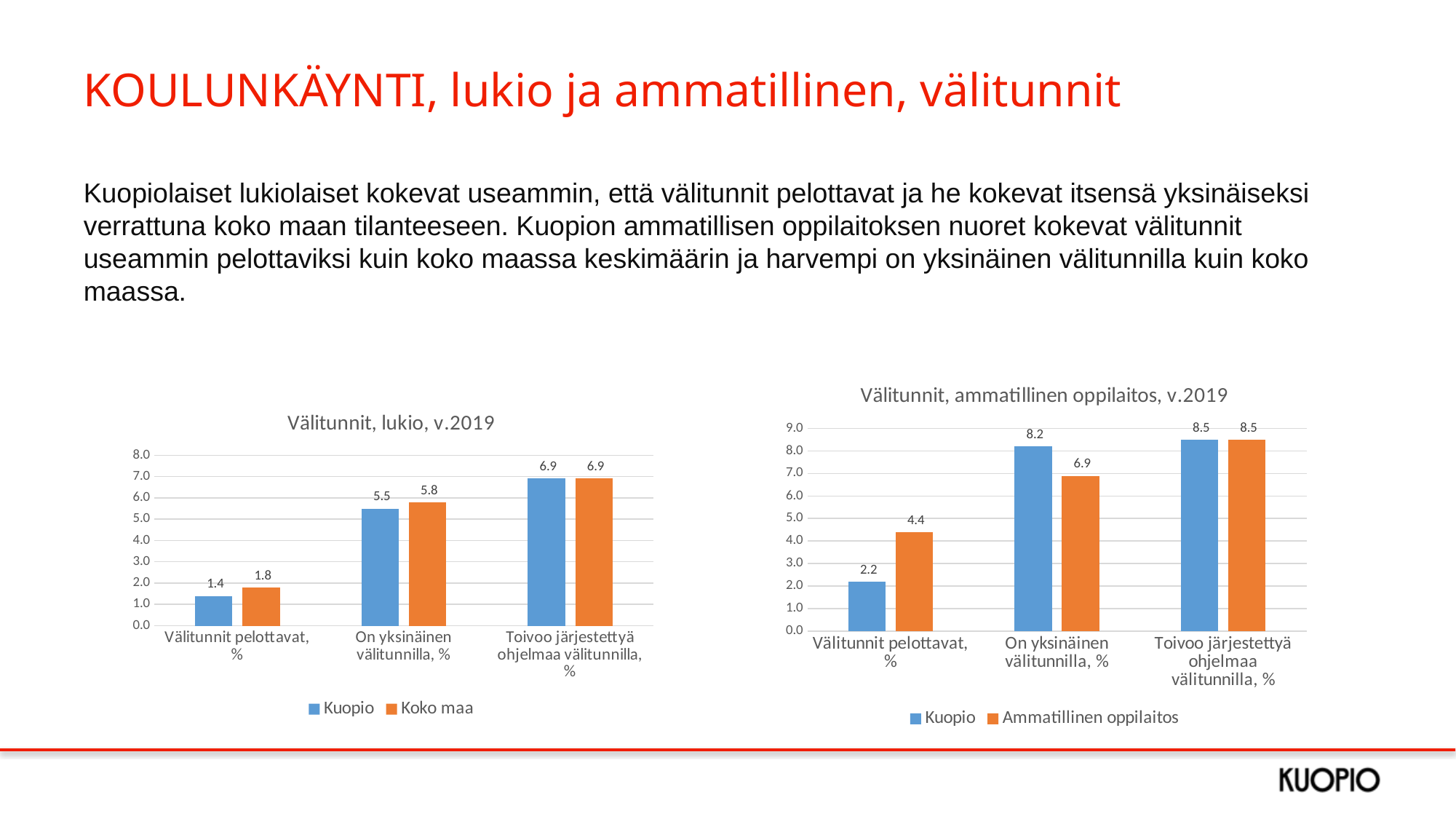
How many series does the legend of the chart 'Välitunnit, ammatillinen oppilaitos, v.2019' list? 2 In the chart 'Välitunnit, lukio, v.2019', which category has the lowest Koko maa value? Välitunnit pelottavat, % How many categories are shown on the x axis of the chart 'Välitunnit, lukio, v.2019'? 3 In the chart 'Välitunnit, ammatillinen oppilaitos, v.2019', which is larger for 'Välitunnit pelottavat, %': Kuopio or Ammatillinen oppilaitos? Ammatillinen oppilaitos In the chart 'Välitunnit, lukio, v.2019', what is the difference between the Koko maa and Kuopio values for 'Välitunnit pelottavat, %'? 0.4 In the chart 'Välitunnit, ammatillinen oppilaitos, v.2019', which category has the highest Kuopio value? Toivoo järjestettyä ohjelmaa välitunnilla, % In the chart 'Välitunnit, ammatillinen oppilaitos, v.2019', what is the Kuopio value for 'On yksinäinen välitunnilla, %'? 8.2 In the chart 'Välitunnit, lukio, v.2019', what is the Koko maa value for 'On yksinäinen välitunnilla, %'? 5.8 In the chart 'Välitunnit, ammatillinen oppilaitos, v.2019', what is the difference between the Kuopio and Ammatillinen oppilaitos values for 'On yksinäinen välitunnilla, %'? 1.3 In the chart 'Välitunnit, lukio, v.2019', what is the Kuopio value for 'Välitunnit pelottavat, %'? 1.4 In the chart 'Välitunnit, ammatillinen oppilaitos, v.2019', what is the Ammatillinen oppilaitos value for 'Välitunnit pelottavat, %'? 4.4 What kind of chart is 'Välitunnit, lukio, v.2019'? Bar chart